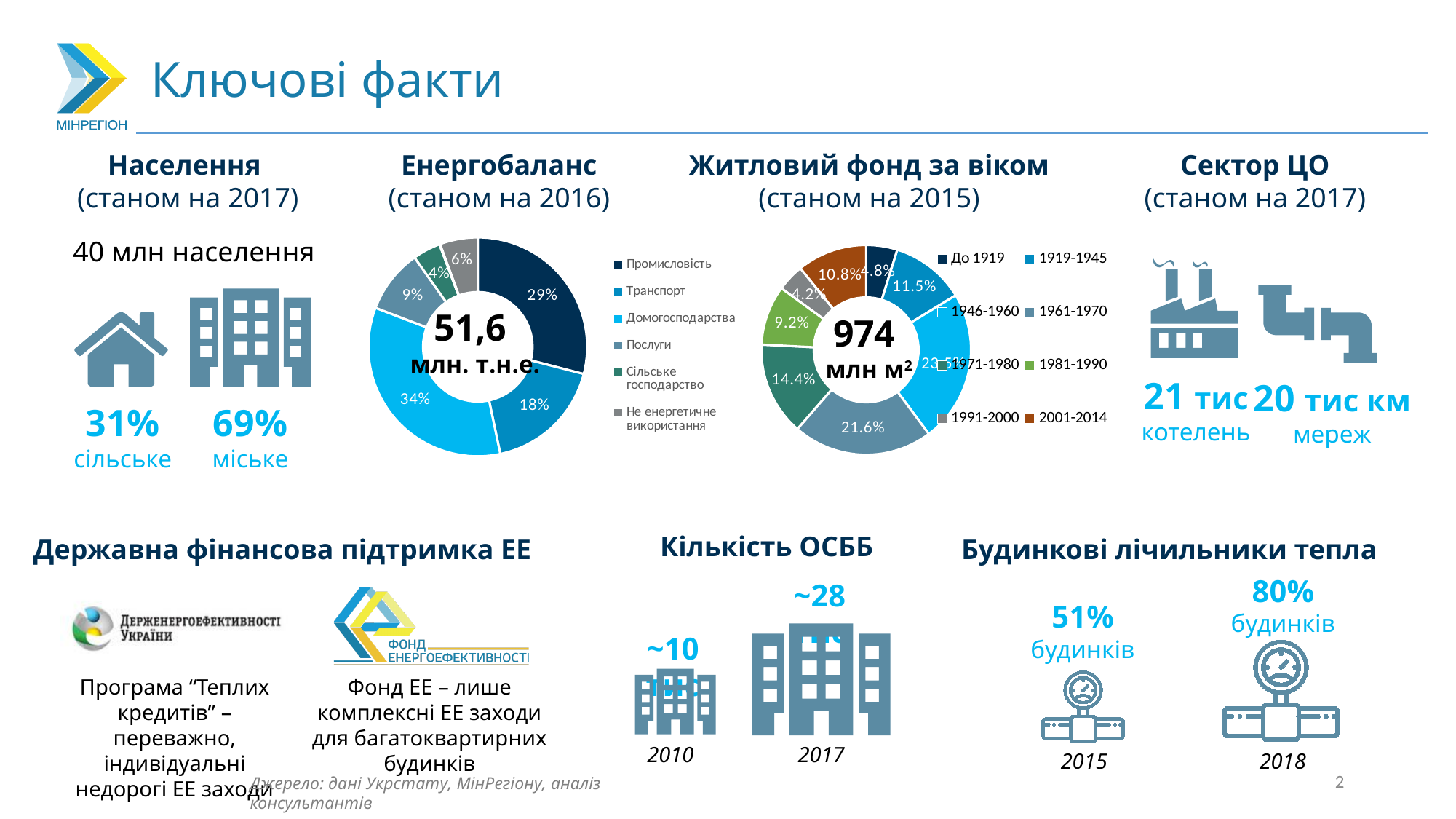
In the 'Житловий фонд за віком (станом на 2015)' chart, which is larger: 1971-1980 or 1981-1990? 1971-1980 In the 'Житловий фонд за віком (станом на 2015)' chart, how many percentage points larger is 2001-2014 than 1991-2000? 6.6 percentage points How many categories does the legend of the 'Енергобаланс (станом на 2016)' chart list? 6 In the 'Енергобаланс (станом на 2016)' chart, what share is shown for Домогосподарства? 34% In the 'Житловий фонд за віком (станом на 2015)' chart, which age category has the smallest share? 1991-2000 In the 'Енергобаланс (станом на 2016)' chart, which category has the smallest share? Сільське господарство How many age categories does the 'Житловий фонд за віком (станом на 2015)' chart show? 8 In the 'Енергобаланс (станом на 2016)' chart, which category has the largest share? Домогосподарства What kind of chart is used for 'Енергобаланс (станом на 2016)'? Pie (donut) chart What total value is printed in the centre of the 'Енергобаланс (станом на 2016)' chart? 51,6 млн. т.н.е. In the 'Енергобаланс (станом на 2016)' chart, how many percentage points larger is Промисловість than Транспорт? 11 percentage points In the 'Житловий фонд за віком (станом на 2015)' chart, what share is shown for 1961-1970? 21.6%